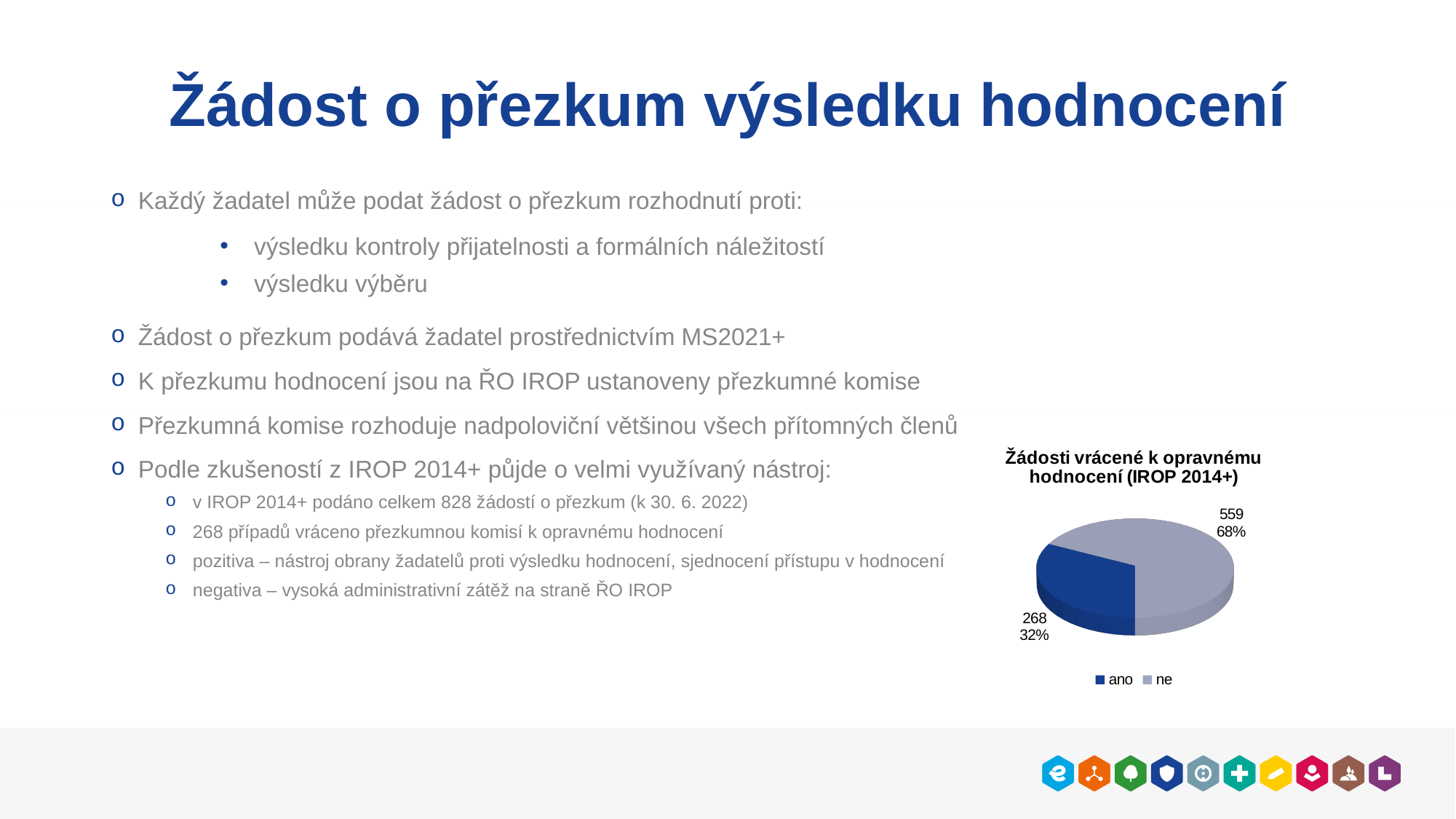
What is the value for "ano" in the pie chart? 268 How many categories does the pie chart show? 2 What is the title of the chart? Žádosti vrácené k opravnému hodnocení (IROP 2014+) Which is larger, the value for "ano" or the value for "ne"? ne What is the difference between the values for "ne" and "ano"? 291 Which category has the largest slice in the pie chart? ne What share of the pie does the "ano" slice represent? 32% What is the value for "ne" in the pie chart? 559 What is the total of the two values shown in the pie chart? 827 Which category has the smallest slice in the pie chart? ano What share of the pie does the "ne" slice represent? 68% What kind of chart is shown on the slide? pie chart